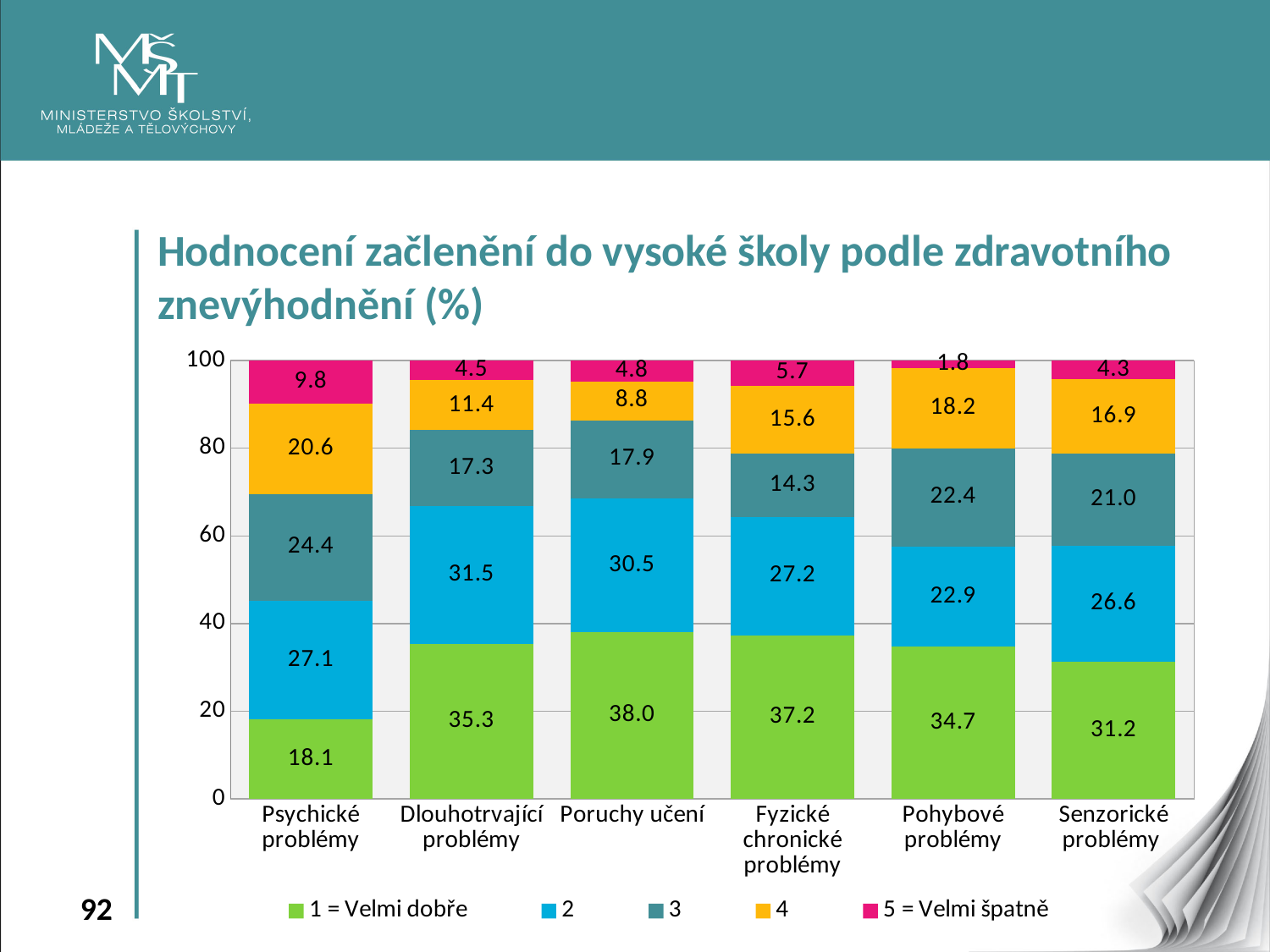
How many categories are shown on the x axis? 6 Which is larger: the series "3" value for Pohybové problémy or for Fyzické chronické problémy? Pohybové problémy What is the total of the stacked bar for Senzorické problémy? 100.0 What is the value of series "2" for Dlouhotrvající problémy? 31.5 What is the difference between the "5 = Velmi špatně" values for Psychické problémy and Senzorické problémy? 5.5 What is the value of the "1 = Velmi dobře" series for Psychické problémy? 18.1 Which category has the lowest value for the "5 = Velmi špatně" series? Pohybové problémy How many series does the legend list? 5 What kind of chart is shown on the slide? Stacked bar chart Which category has the highest value for the "1 = Velmi dobře" series? Poruchy učení What is the value of series "4" for Pohybové problémy? 18.2 Which legend entry is shown in green? 1 = Velmi dobře